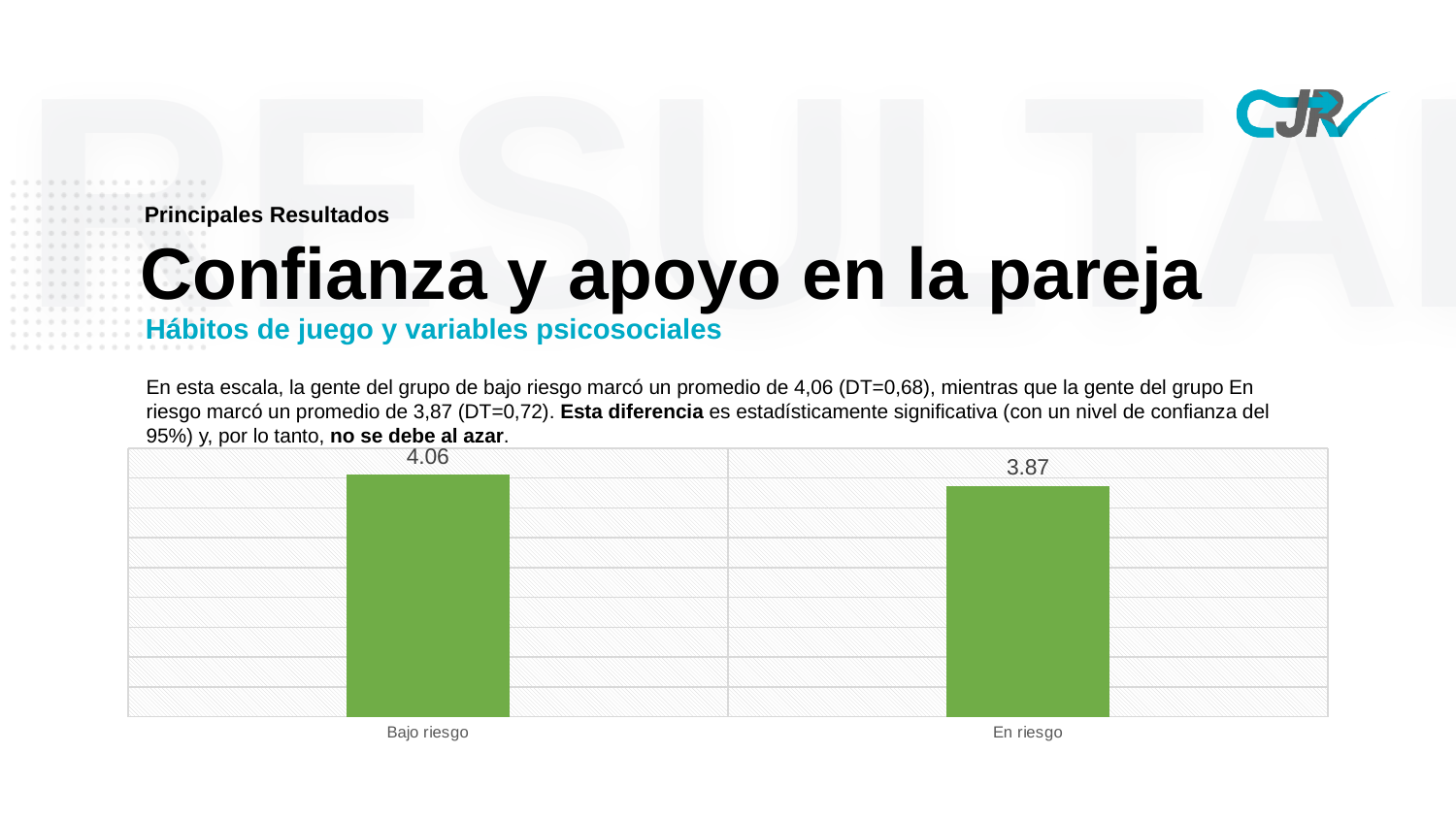
Which category has the highest value? Bajo riesgo What is the difference between the values for Bajo riesgo and En riesgo? 0.19 What is the label of the first category on the x axis? Bajo riesgo What is the value for En riesgo? 3.87 What colour are the bars in the chart? Green Which is larger, the value for Bajo riesgo or the value for En riesgo? Bajo riesgo Do the values rise or fall from Bajo riesgo to En riesgo? Fall What is the value for Bajo riesgo? 4.06 Which category has the lowest value? En riesgo How many categories are shown in the chart? 2 What kind of chart is shown on the slide? Bar chart